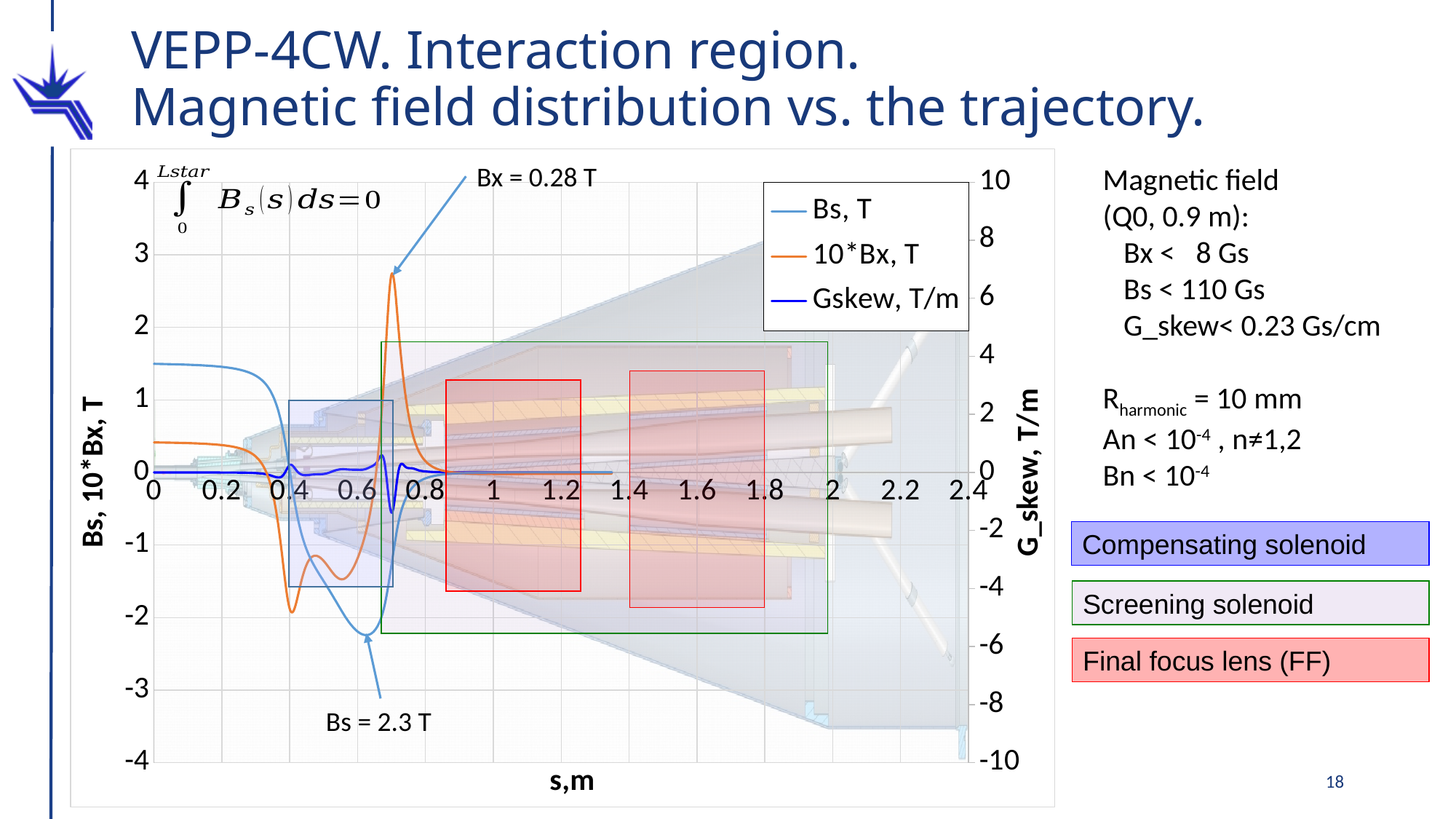
What peak value of Bx is annotated on the chart? 0.28 T Is the peak of the 10*Bx, T series near s = 0.7 greater or less than 2 on the left axis? greater What kind of chart is shown on the slide? line chart What are the three series listed in the chart legend? Bs, T; 10*Bx, T; Gskew, T/m What is the label of the x axis of the chart? s,m What peak value of Bs is annotated on the chart? 2.3 T Does the Bs, T series rise or fall as s goes from 0 to 0.8 m? fall Is the value of the 10*Bx, T series at s = 0 greater or less than 1? less What is the maximum value shown on the right-hand G_skew, T/m axis? 10 How many series does the chart legend list? 3 Is the value of the Bs, T series at s = 0 greater or less than 1? greater